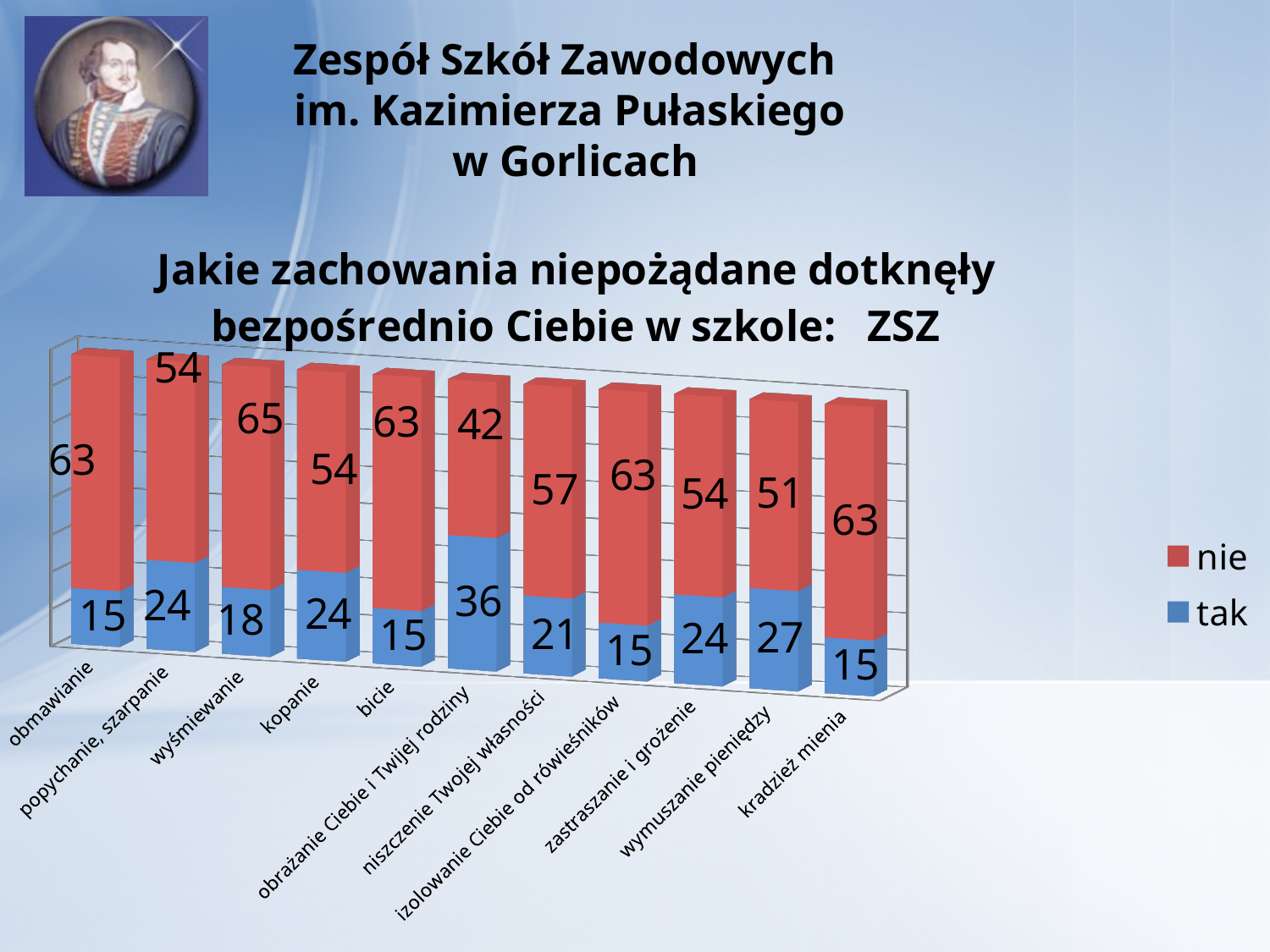
Which category has the lowest "nie" value? obrażanie Ciebie i Twojej rodziny What is the "nie" value for wyśmiewanie? 65 How many categories are shown on the x axis? 11 What is the "nie" value for niszczenie Twojej własności? 57 Which category has the highest "tak" value? obrażanie Ciebie i Twojej rodziny What is the "tak" value for obrażanie Ciebie i Twojej rodziny? 36 How many series does the legend list? 2 What is the difference between the "nie" and "tak" values for kopanie? 30 Which category has the highest "nie" value? wyśmiewanie Which is larger: the "tak" value for wymuszanie pieniędzy or the "tak" value for niszczenie Twojej własności? wymuszanie pieniędzy What is the "tak" value for wymuszanie pieniędzy? 27 What is the total of the stacked bar for obrażanie Ciebie i Twojej rodziny? 78